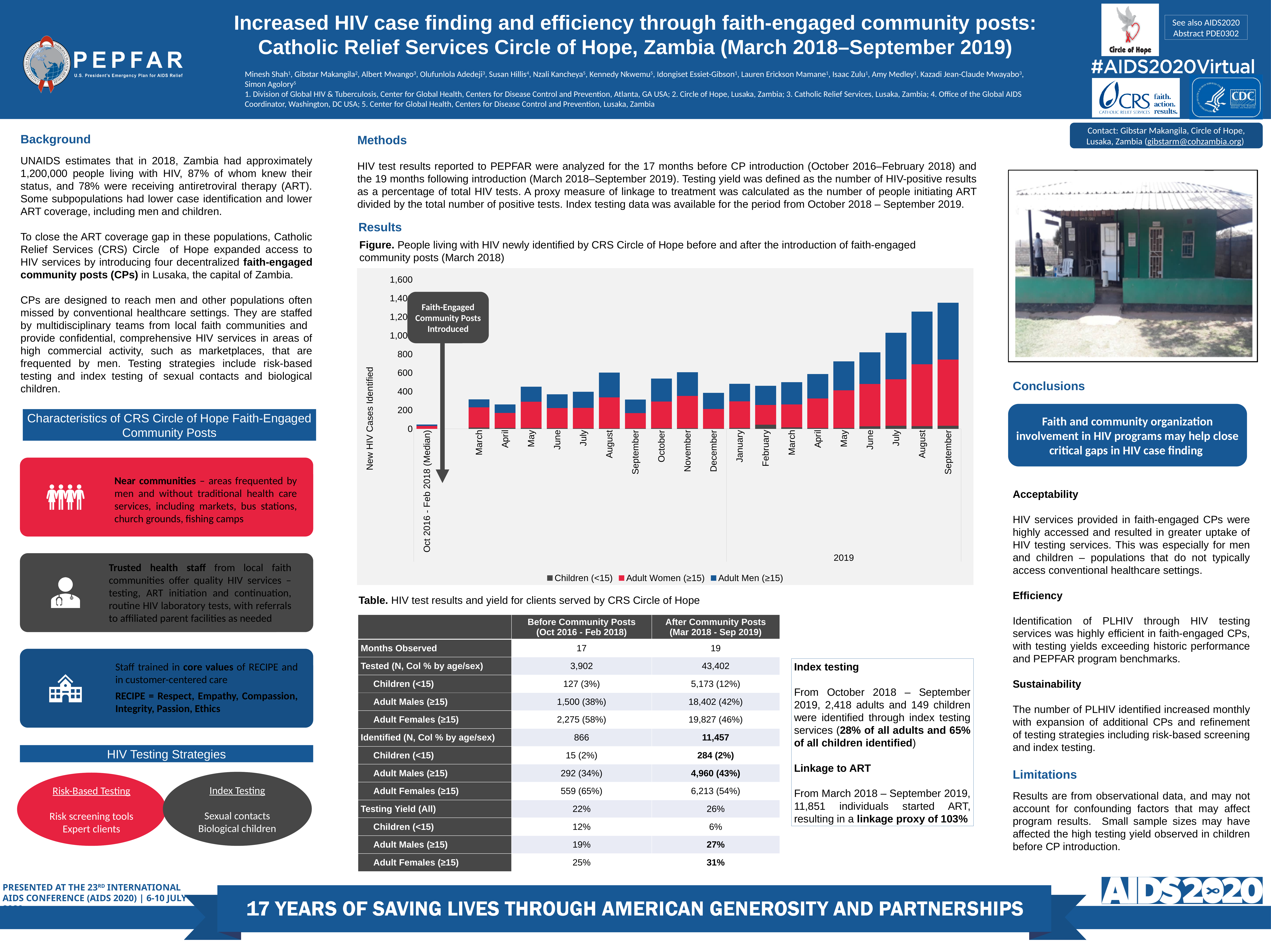
Is the total for September 2019 greater or less than 1,200? greater Which bar is taller in the chart, August 2018 or September 2018? August 2018 How many series does the legend of the chart list? 3 Which bar in the chart has the lowest total of new HIV cases identified? Oct 2016 - Feb 2018 (Median) Is the total for the Oct 2016 - Feb 2018 (Median) bar greater or less than 200? less How many bars are plotted in the chart, including the Oct 2016 - Feb 2018 (Median) bar? 20 Which month has the highest total of new HIV cases identified in the chart? September 2019 Do the total new HIV cases identified generally rise or fall from March 2018 to September 2019? Rise Is the total for May 2019 greater or less than 600? greater What kind of chart is used to show people living with HIV newly identified by CRS Circle of Hope? Stacked bar chart Which series are listed in the chart legend? Children (<15), Adult Women (≥15), Adult Men (≥15) What does the annotation with the arrow on the chart say was introduced? Faith-Engaged Community Posts Introduced